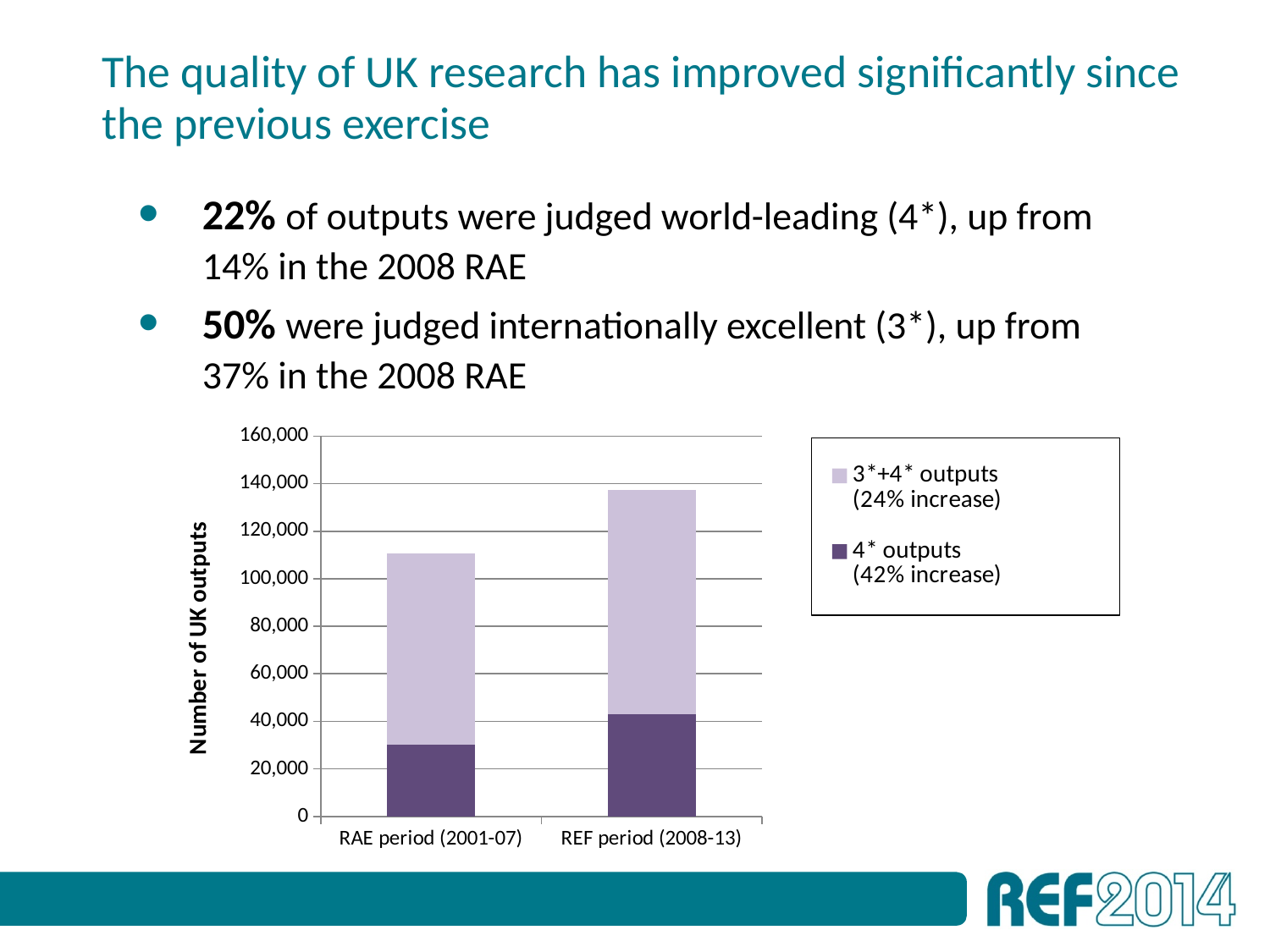
Which period has the taller stacked bar, RAE period (2001-07) or REF period (2008-13)? REF period (2008-13) What kind of chart is shown on the slide? bar chart Is the total height of the bar for REF period (2008-13) greater or less than 120,000? greater Is the total height of the bar for RAE period (2001-07) greater or less than 100,000? greater Do the total bar heights rise or fall from the RAE period to the REF period? rise Is the 4* outputs segment for RAE period (2001-07) greater or less than 40,000? less Which period has the larger 4* outputs segment, RAE period (2001-07) or REF period (2008-13)? REF period (2008-13) Which legend entry is shown in the darker purple colour? 4* outputs (42% increase) What is the label of the y axis of the chart? Number of UK outputs How many categories are shown on the x axis of the chart? 2 How many series does the chart's legend list? 2